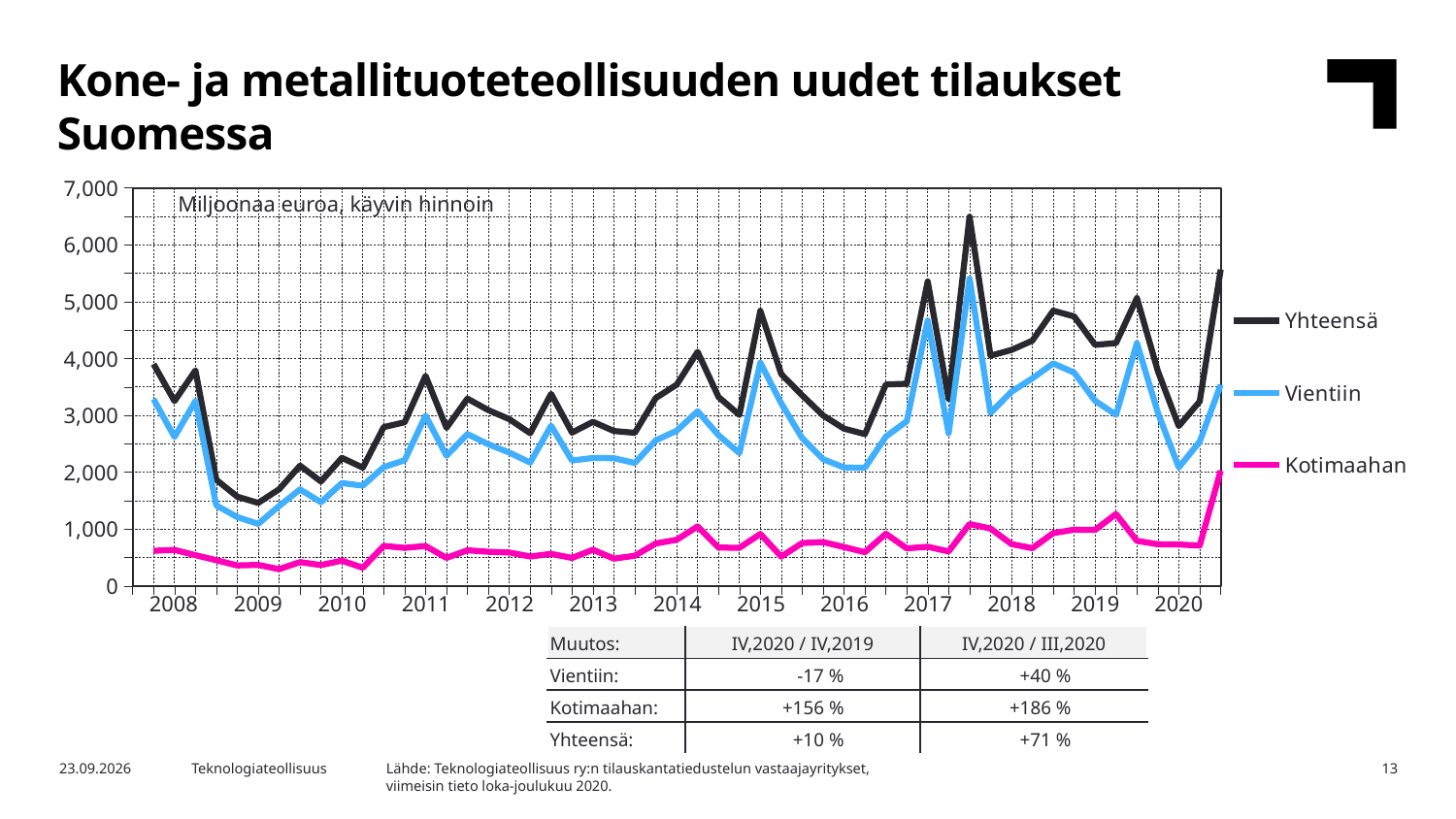
Which series has the lowest values throughout the chart? Kotimaahan What is the title of the chart on the slide? Kone- ja metallituoteteollisuuden uudet tilaukset Suomessa How many series does the legend list? 3 What are the three series named in the legend? Yhteensä, Vientiin, Kotimaahan Is the lowest value of Vientiin in 2009 greater or less than 2,000? less Is the peak value of Yhteensä in 2017 greater or less than 6,000? greater How many year labels are shown on the x axis? 13 Which series has the highest values throughout the chart? Yhteensä Which series is larger in 2015, Vientiin or Kotimaahan? Vientiin Is the value of Kotimaahan at the start of 2008 greater or less than 1,000? less What kind of chart is shown on the slide? line chart